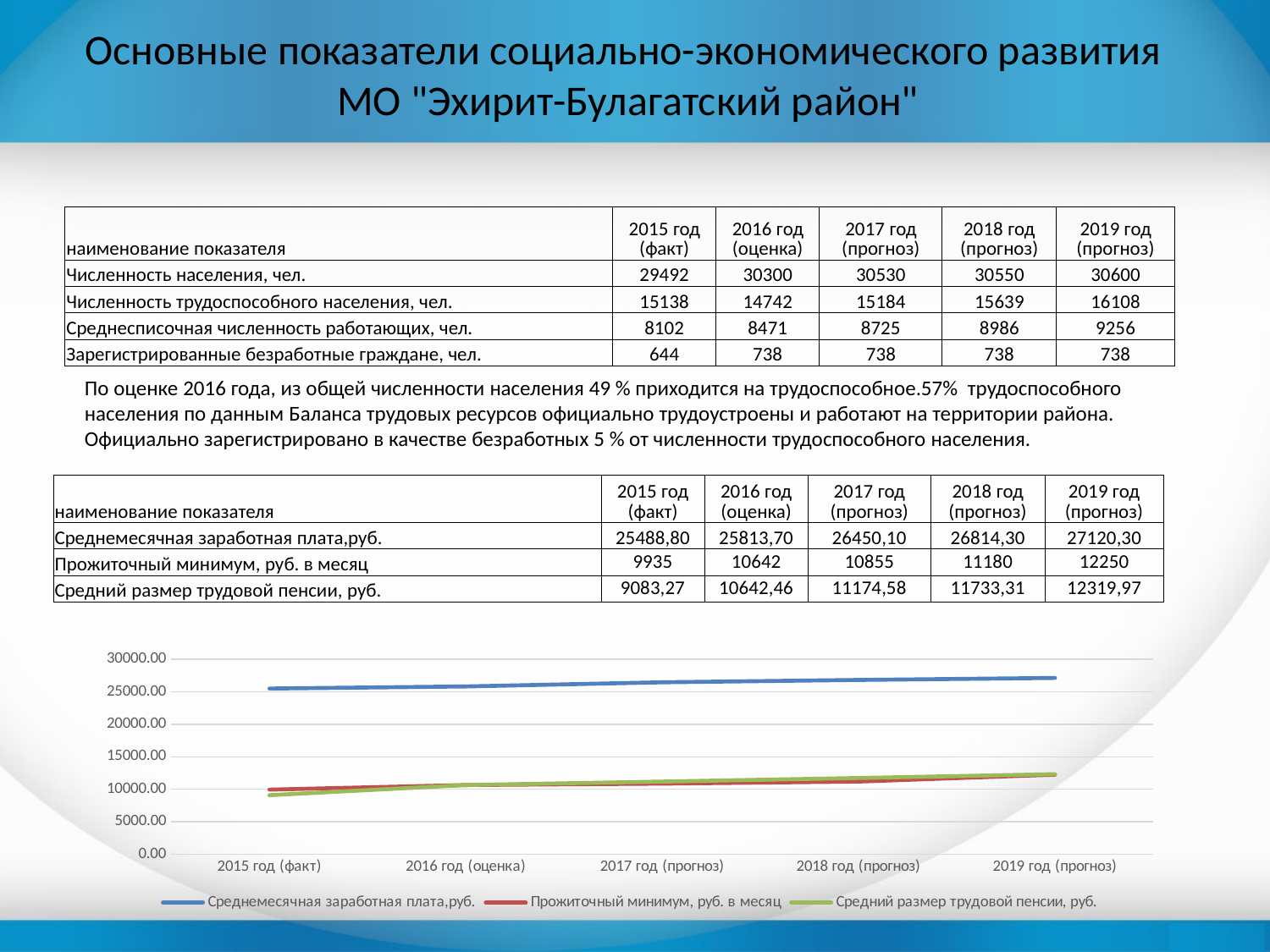
In the line chart, which is larger in 2015 год (факт): Прожиточный минимум, руб. в месяц or Средний размер трудовой пенсии, руб.? Прожиточный минимум, руб. в месяц How many series does the legend of the line chart list? 3 What kind of chart is shown at the bottom of the slide? line chart Is the value for Средний размер трудовой пенсии, руб. in 2015 год (факт) greater or less than 10000.00? less How many points along the x axis does the line chart have? 5 Does the line for Среднемесячная заработная плата,руб. rise or fall from 2015 год (факт) to 2019 год (прогноз)? rise Is the value for Среднемесячная заработная плата,руб. in 2015 год (факт) greater or less than 20000.00? greater What is the value of Прожиточный минимум, руб. в месяц for 2016 год (оценка), as printed in the table above the chart? 10642 Is the value for Прожиточный минимум, руб. в месяц in 2019 год (прогноз) greater or less than 15000.00? less What is the label of the first category on the x axis of the line chart? 2015 год (факт) What is the value of Среднемесячная заработная плата,руб. for 2019 год (прогноз), as printed in the table above the chart? 27120,30 Which series in the line chart has the highest values across all years? Среднемесячная заработная плата,руб.